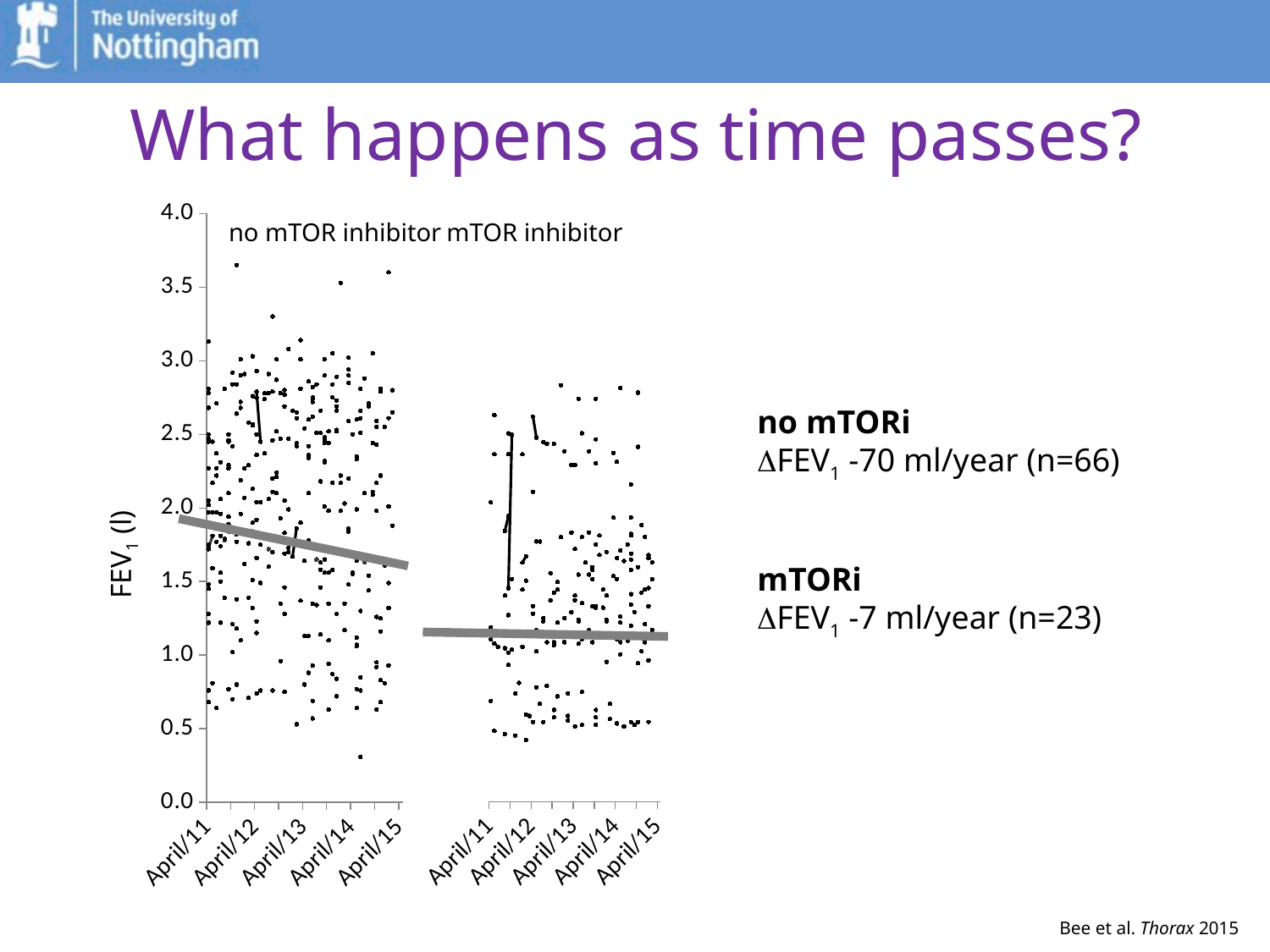
What is the highest value shown on the y axis of the chart? 4.0 What is the label of the y axis of the chart? FEV1 (l) Which group shows the steeper decline in FEV1 per year, no mTORi or mTORi? no mTORi How many panels (groups) does the scatter plot show? 2 What is the annual change in FEV1 for the mTORi group? -7 ml/year Does the grey trend line for the 'no mTOR inhibitor' panel rise or fall from April/11 to April/15? fall How many labelled time points are on the x axis of each panel? 5 Is the grey trend line for the 'no mTOR inhibitor' panel at April/11 greater or less than 1.5? greater What kind of chart is shown on the slide? scatter plot Is the grey trend line for the 'mTOR inhibitor' panel greater or less than 1.5? less What is the annual change in FEV1 for the no mTORi group? -70 ml/year How many patients are in the no mTORi group? 66